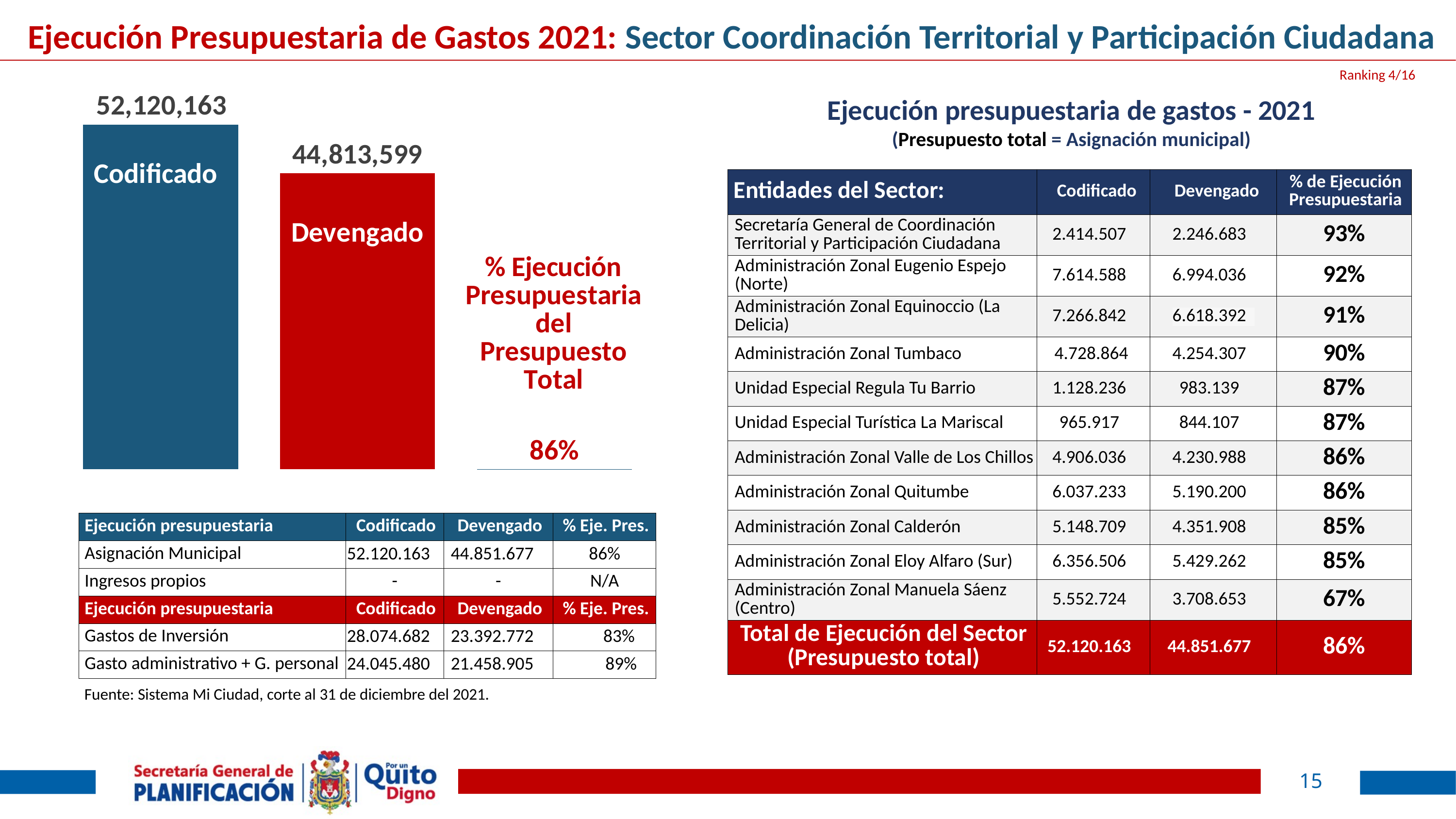
Which bar in the chart is the lowest? Devengado How many bars are plotted in the bar chart? 2 What is the difference between the Codificado and Devengado bars in the chart? 7,306,564 What colour is the Devengado bar in the chart? Red What colour is the Codificado bar in the chart? Blue Which bar in the chart is the highest? Codificado What kind of chart is shown on the left of the slide? Bar chart What is the value of the Codificado bar in the bar chart? 52,120,163 What is the value of the Devengado bar in the bar chart? 44,813,599 Which is larger in the bar chart, Codificado or Devengado? Codificado